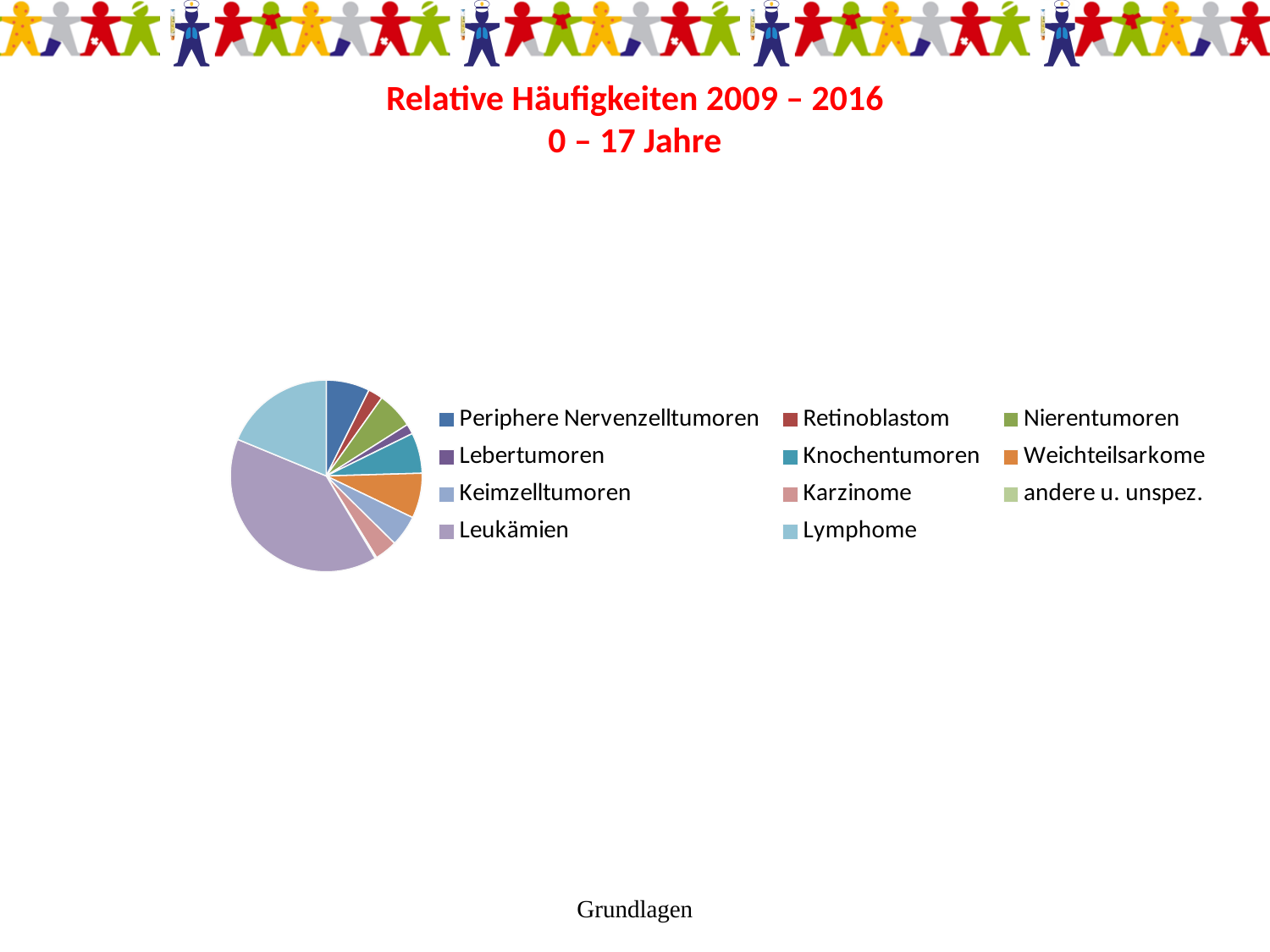
Which slice is larger, Leukämien or Weichteilsarkome? Leukämien Which slice is larger, Leukämien or Lymphome? Leukämien Which category has the largest slice of the pie chart? Leukämien What is the title of the slide containing the pie chart? Relative Häufigkeiten 2009 – 2016 0 – 17 Jahre Which slice is larger, Lymphome or Retinoblastom? Lymphome How many categories does the legend of the pie chart list? 11 What kind of chart is shown on the slide? pie chart Which legend entry is shown with an orange colour? Weichteilsarkome